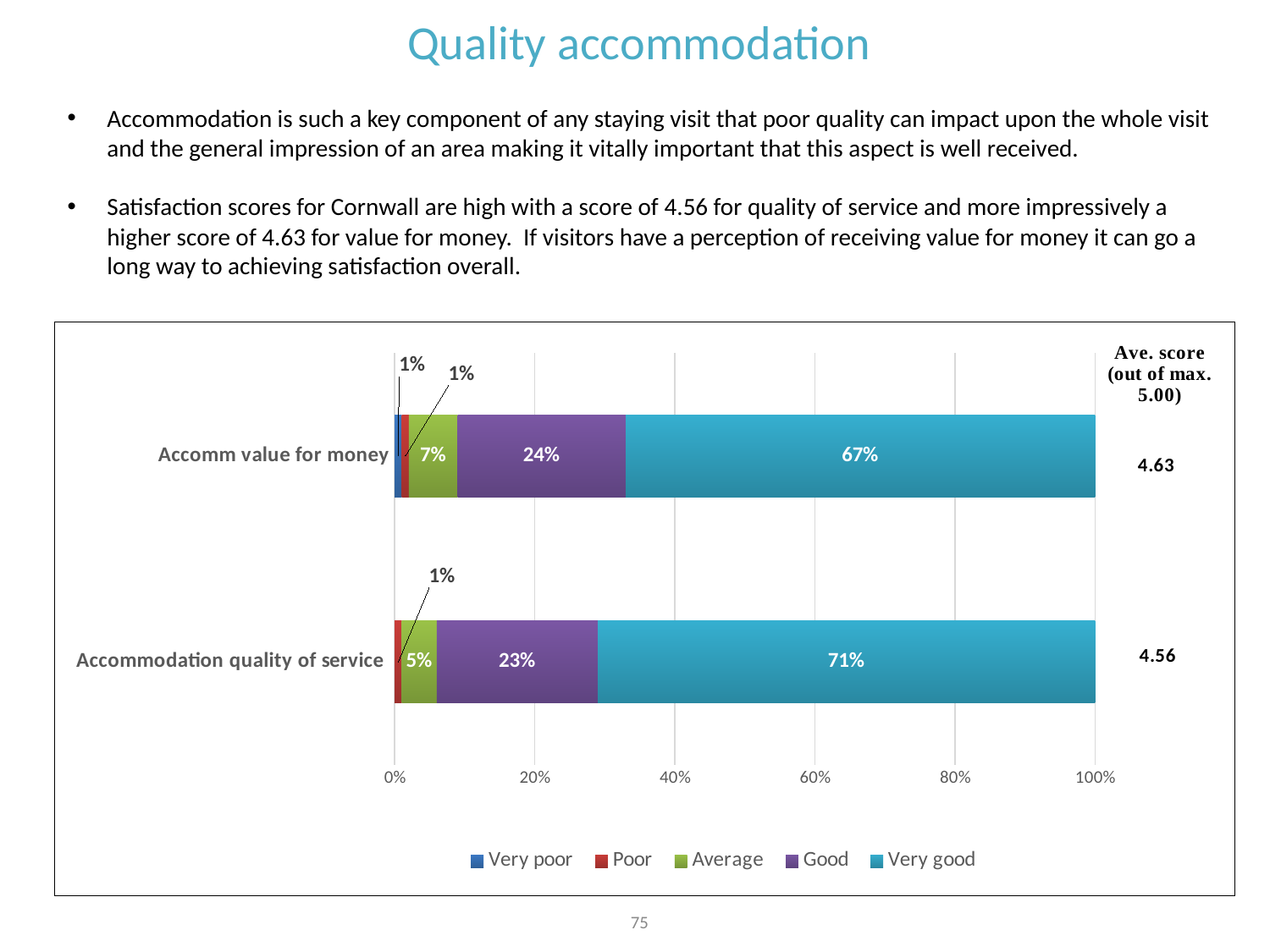
What is the 'Good' value for Accomm value for money? 24% How many series does the legend list? 5 How many categories are plotted on the chart? 2 What is the 'Average' value for Accommodation quality of service? 5% What is the 'Very good' value for Accommodation quality of service? 71% What is the difference between the 'Very good' values for Accommodation quality of service and Accomm value for money? 4% What is the average score (out of max. 5.00) shown for Accomm value for money? 4.63 What is the 'Very good' value for Accomm value for money? 67% What type of chart is shown on the slide? Stacked bar chart Which category has the higher 'Very good' share? Accommodation quality of service Which series is shown in the legend immediately after 'Average'? Good What is the 'Average' value for Accomm value for money? 7%